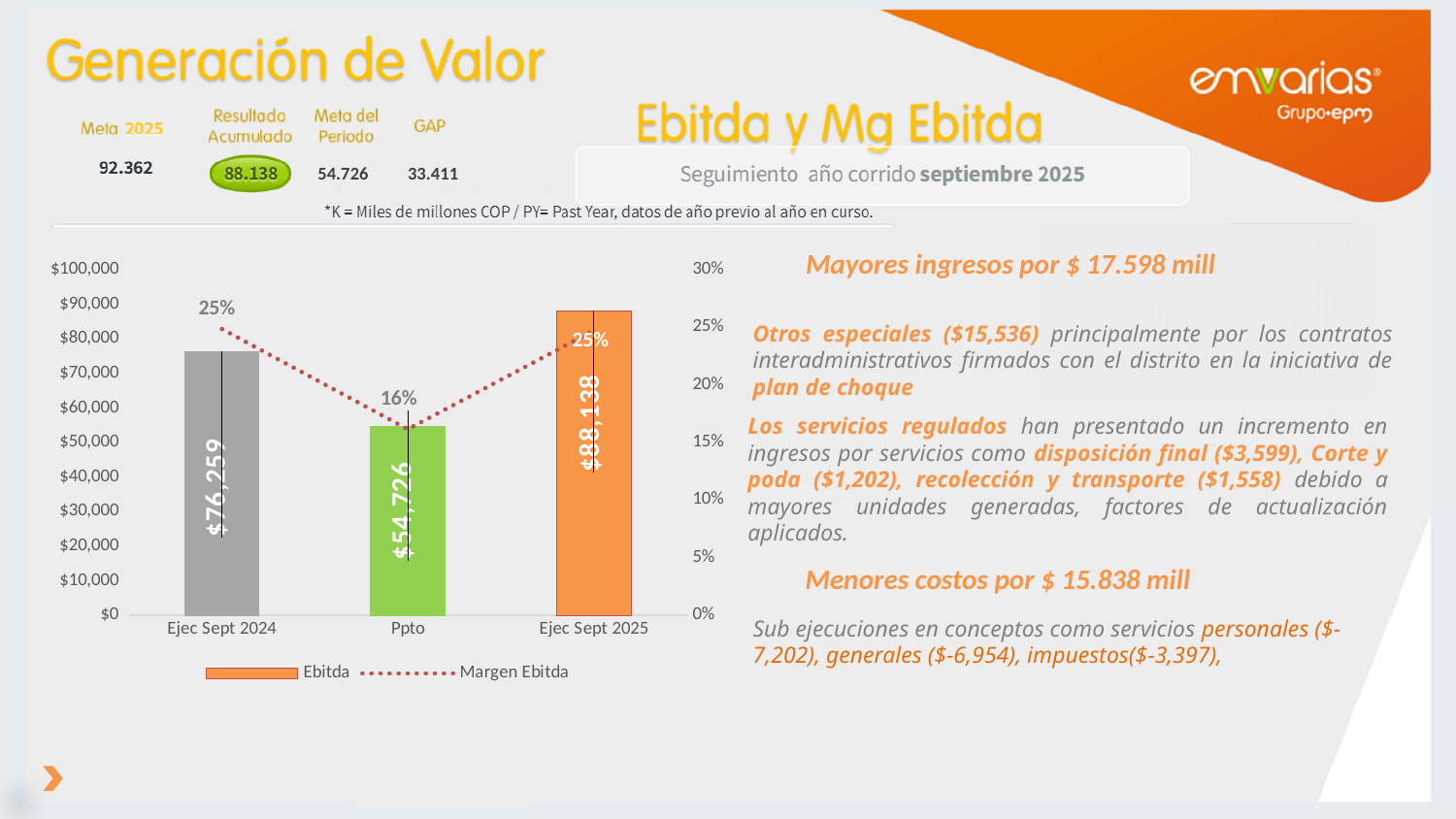
Which category has the highest Ebitda? Ejec Sept 2025 Which is larger, the Ebitda for Ejec Sept 2024 or for Ppto? Ejec Sept 2024 What kind of chart is used to show the Ebitda values? Bar chart What is the Ebitda value for Ppto? $54,726 What is the difference in Ebitda between Ejec Sept 2024 and Ppto? $21,533 What is the Ebitda value for Ejec Sept 2024? $76,259 What is the Margen Ebitda for Ppto? 16% How many categories are shown on the x axis of the chart? 3 What is the Ebitda value for Ejec Sept 2025? $88,138 How many series does the chart legend list? 2 What is the difference in Ebitda between Ejec Sept 2025 and Ejec Sept 2024? $11,879 Which category has the lowest Ebitda? Ppto